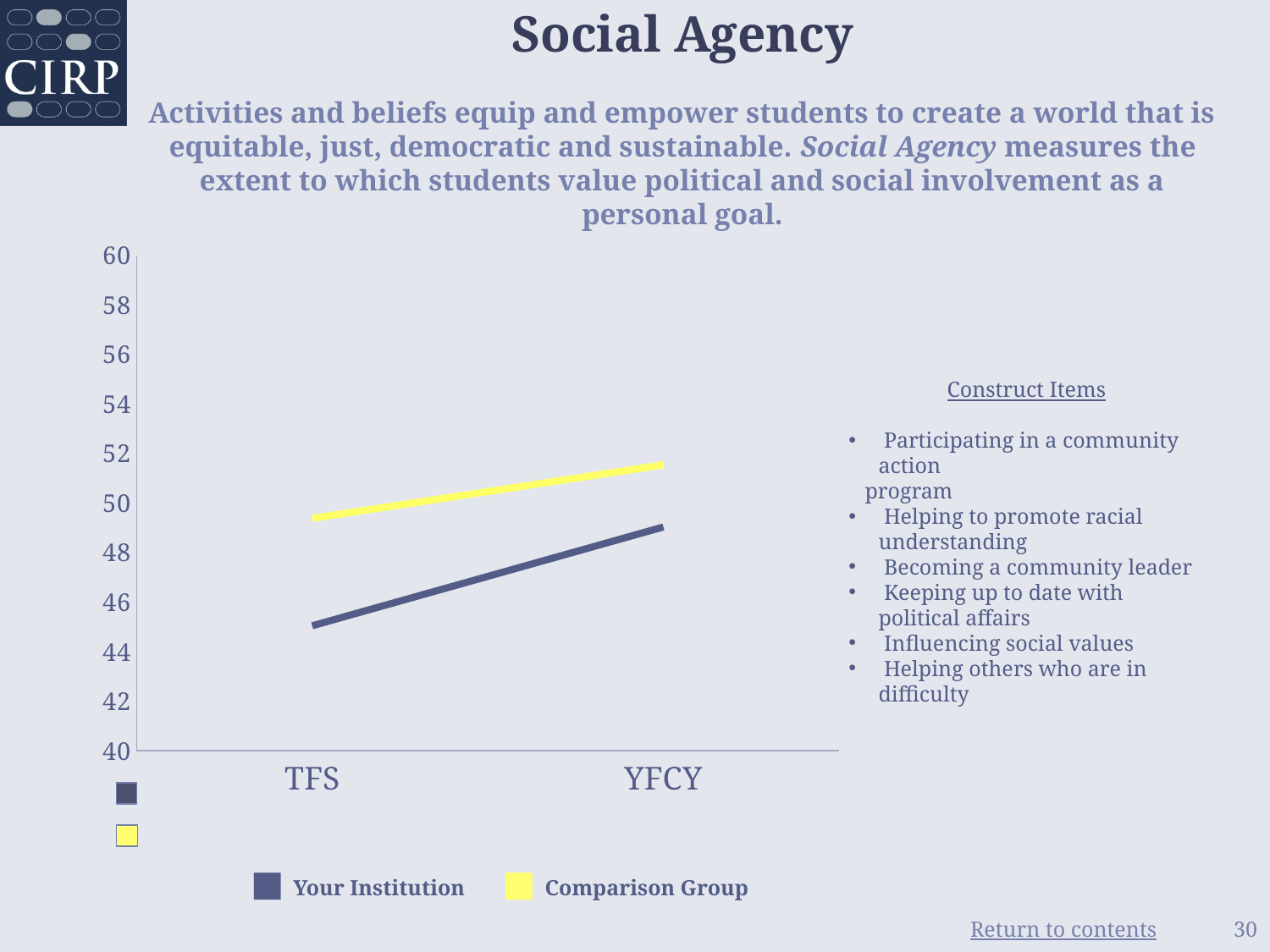
Does the Your Institution line rise or fall from TFS to YFCY? rise Is the value for Comparison Group at TFS greater or less than 48? greater At YFCY, which series has the higher value, Your Institution or Comparison Group? Comparison Group Does the Comparison Group line rise or fall from TFS to YFCY? rise Is the value for Comparison Group at YFCY greater or less than 50? greater How many points are on the x axis of the chart? 2 At TFS, which series has the higher value, Your Institution or Comparison Group? Comparison Group Is the value for Your Institution at YFCY greater or less than 50? less Which series is plotted in yellow? Comparison Group What kind of chart is shown on the slide? line chart How many series does the legend list? 2